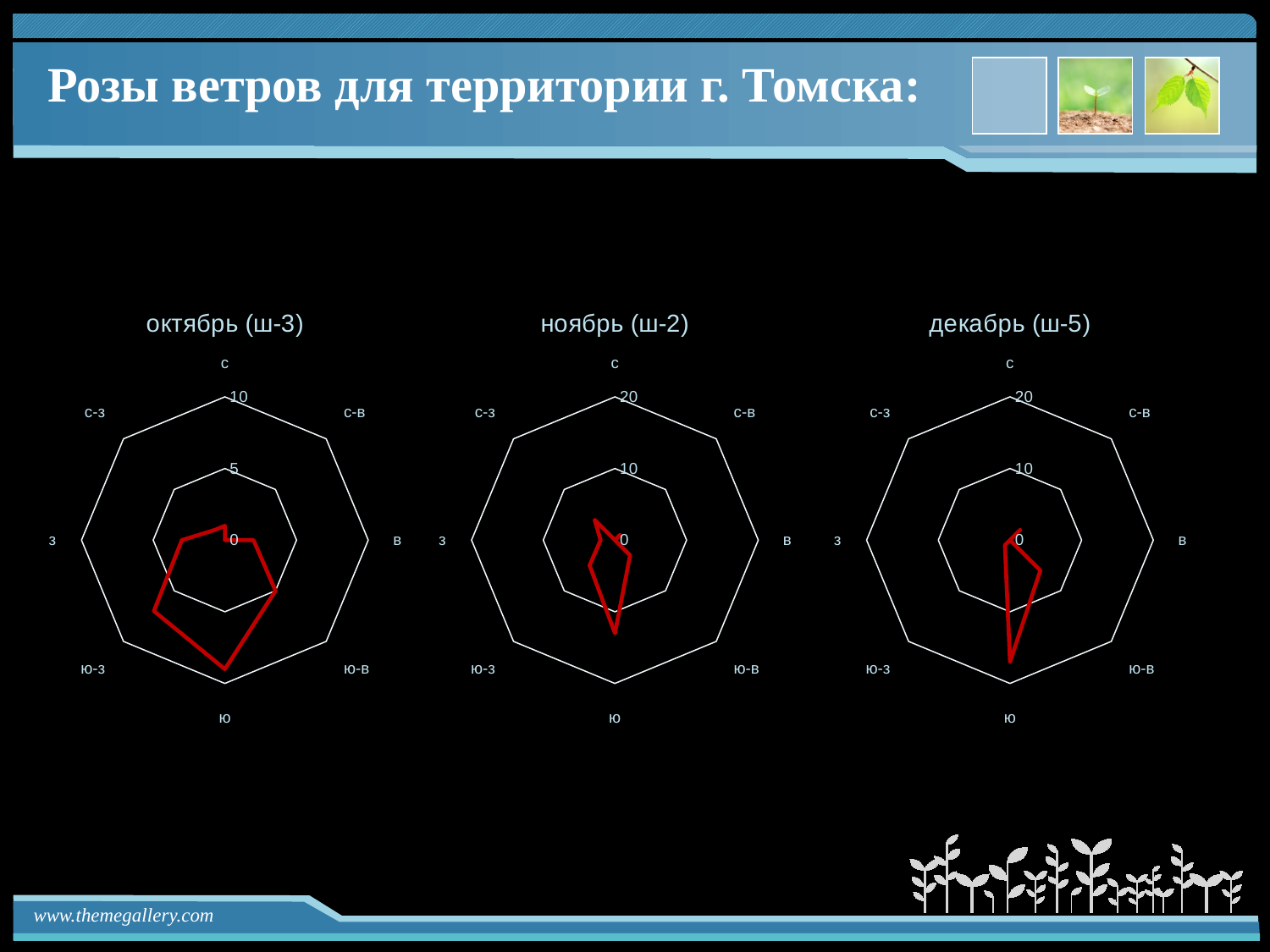
How many direction categories does the "ноябрь (ш-2)" chart have? 8 What is the title of the chart on the right of the slide? декабрь (ш-5) In the "декабрь (ш-5)" chart, is the value for с-в greater or less than 10? less In the "октябрь (ш-3)" chart, is the value for с greater or less than 5? less In the "ноябрь (ш-2)" chart, is the value for ю greater or less than 10? greater In the "декабрь (ш-5)" chart, which direction has the highest value? ю What kind of chart is the "октябрь (ш-3)" chart? radar chart In the "ноябрь (ш-2)" chart, which direction has the highest value? ю How many charts are shown on the slide? 3 In the "декабрь (ш-5)" chart, which is larger, the value for ю or the value for с? ю In the "октябрь (ш-3)" chart, which direction has the highest value? ю